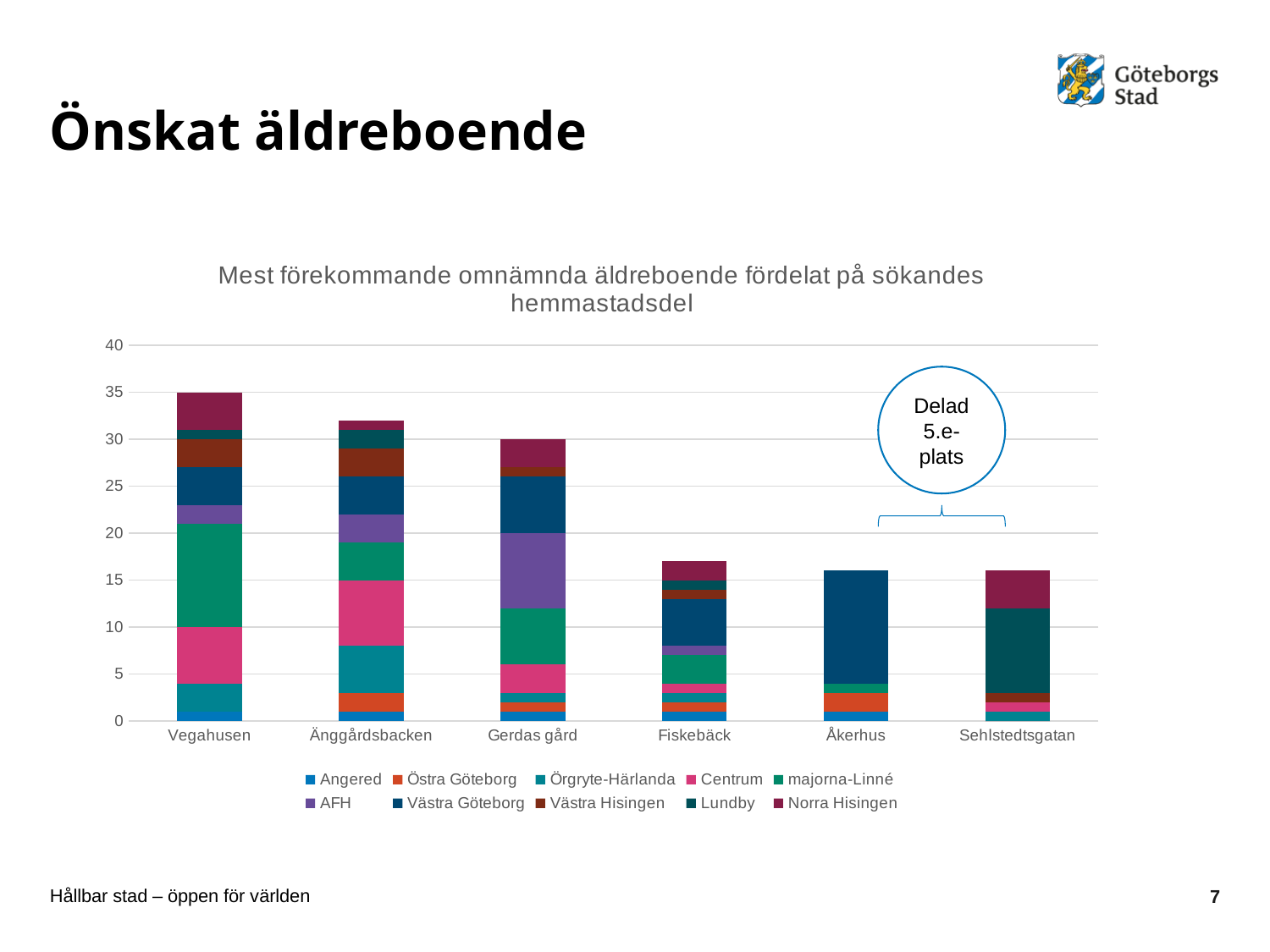
What is the title of the chart? Mest förekommande omnämnda äldreboende fördelat på sökandes hemmastadsdel How many care homes (categories) are shown on the x axis of the chart? 6 Which series is listed first in the chart's legend? Angered What kind of chart is shown on the slide? Stacked bar chart Which care home has the highest total bar in the chart? Vegahusen What is the total height of the stacked bar for Gerdas gård? 30 Is the total bar for Änggårdsbacken greater or less than 30? greater How many series does the chart's legend list? 10 Do the total bar heights generally rise or fall from left to right along the x axis? Fall Which has a taller total bar, Vegahusen or Fiskebäck? Vegahusen What is the total height of the stacked bar for Vegahusen? 35 Is the total bar for Fiskebäck greater or less than 20? less